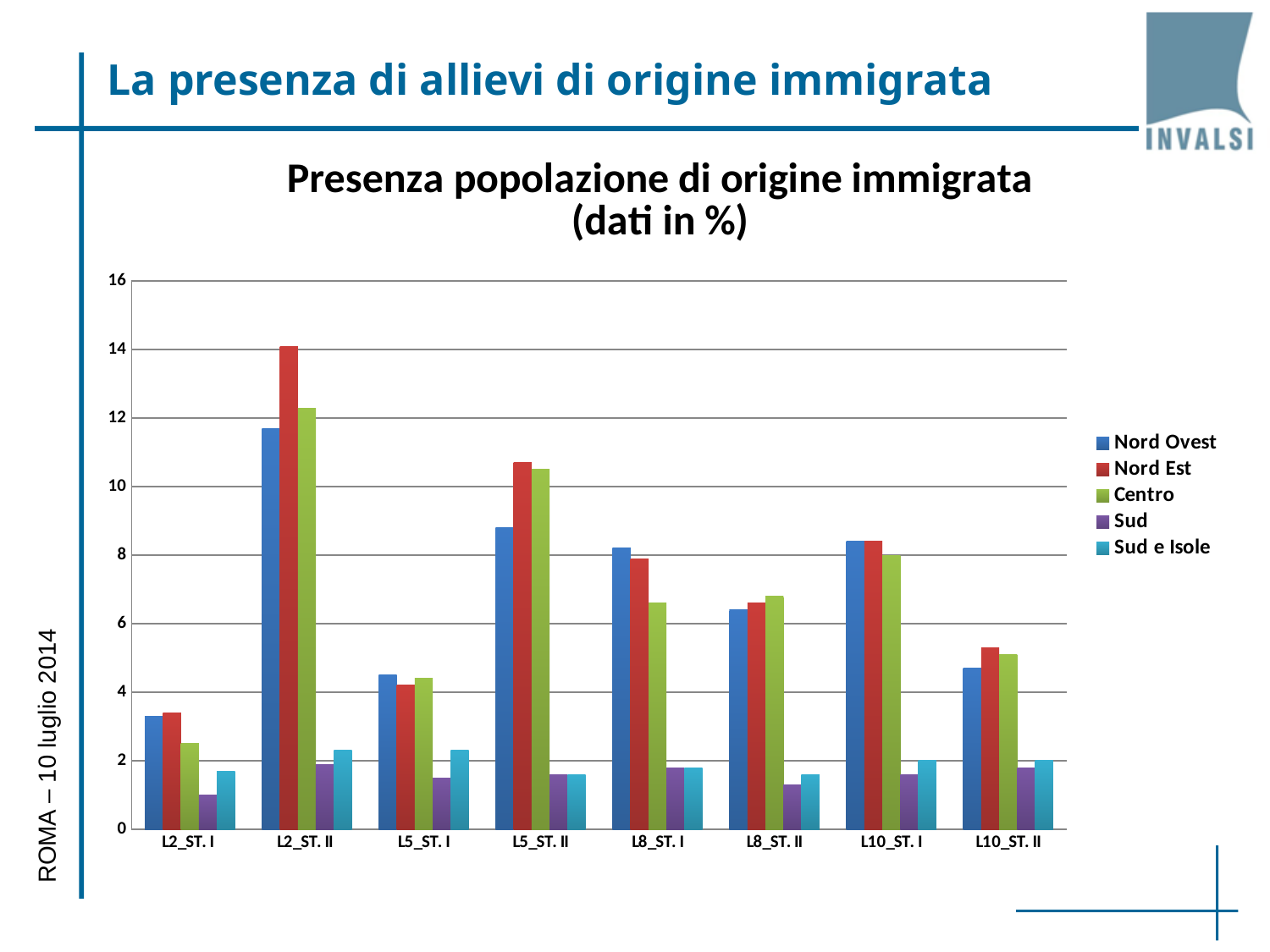
Is the value for Sud in L2_ST. I greater or less than 2? less How many categories are shown on the x axis? 8 Is the value for Nord Est in L2_ST. II greater or less than 12? greater How many series does the legend list? 5 Which series has the highest bar in the L2_ST. II category? Nord Est Is the value for Centro in L8_ST. I greater or less than 8? less In the L2_ST. I category, which is larger: Nord Ovest or Centro? Nord Ovest What kind of chart is shown on the slide? bar chart Which series has the lowest bar in the L2_ST. I category? Sud Across all categories, which category contains the tallest bar in the chart? L2_ST. II What is the title of the chart? Presenza popolazione di origine immigrata (dati in %)